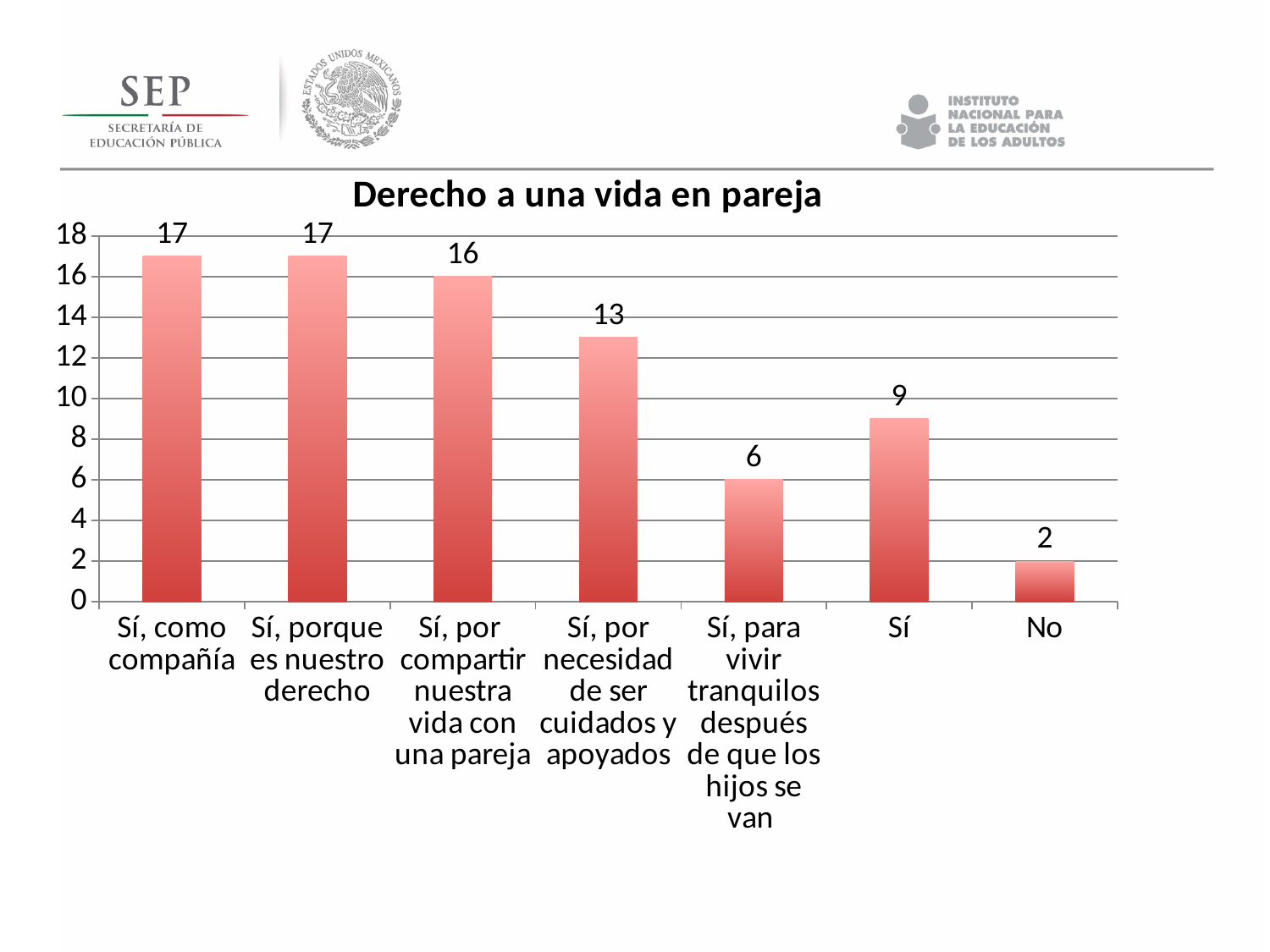
What is the difference between the values for "Sí, por compartir nuestra vida con una pareja" and "Sí"? 7 What is the title of the chart? Derecho a una vida en pareja What is the difference between the values for "Sí, porque es nuestro derecho" and "No"? 15 Is the value for "Sí, por necesidad de ser cuidados y apoyados" greater or less than 10? greater What is the value for "Sí, por necesidad de ser cuidados y apoyados"? 13 What kind of chart is shown? bar chart What is the value for "Sí, como compañía"? 17 Which is larger, the value for "Sí" or the value for "Sí, para vivir tranquilos después de que los hijos se van"? Sí What is the value for "Sí, para vivir tranquilos después de que los hijos se van"? 6 Which category has the lowest value? No How many categories are shown on the x axis? 7 What is the value for "No"? 2